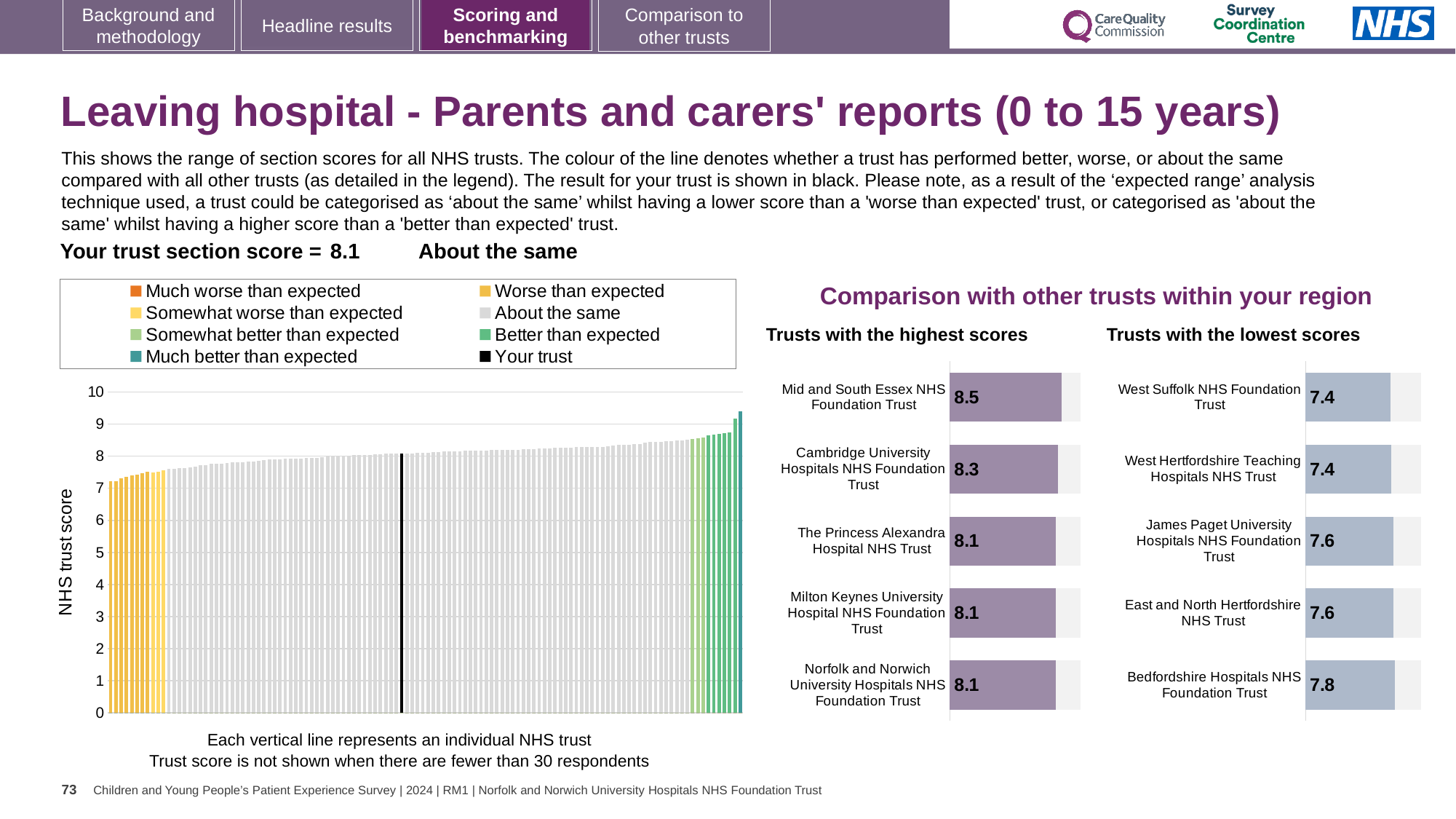
In the large chart on the left showing the range of section scores, what kind of chart is it? Bar chart In the 'Trusts with the highest scores' chart, which trust has the highest score? Mid and South Essex NHS Foundation Trust In the large chart on the left showing the range of section scores, how many entries does the legend list? 8 In the 'Trusts with the lowest scores' chart, which trust has the highest score? Bedfordshire Hospitals NHS Foundation Trust In the 'Trusts with the highest scores' chart, what is the difference between the scores of Mid and South Essex NHS Foundation Trust and Cambridge University Hospitals NHS Foundation Trust? 0.2 In the 'Trusts with the lowest scores' chart, what is the difference between the scores of Bedfordshire Hospitals NHS Foundation Trust and West Hertfordshire Teaching Hospitals NHS Trust? 0.4 In the 'Trusts with the lowest scores' chart, what is the score for West Suffolk NHS Foundation Trust? 7.4 In the 'Trusts with the highest scores' chart, how many trusts are shown? 5 In the 'Trusts with the highest scores' chart, what is the score for Mid and South Essex NHS Foundation Trust? 8.5 In the 'Trusts with the lowest scores' chart, which has the larger score: James Paget University Hospitals NHS Foundation Trust or Bedfordshire Hospitals NHS Foundation Trust? Bedfordshire Hospitals NHS Foundation Trust In the 'Trusts with the highest scores' chart, what is the score for Cambridge University Hospitals NHS Foundation Trust? 8.3 In the 'Trusts with the lowest scores' chart, what is the score for Bedfordshire Hospitals NHS Foundation Trust? 7.8